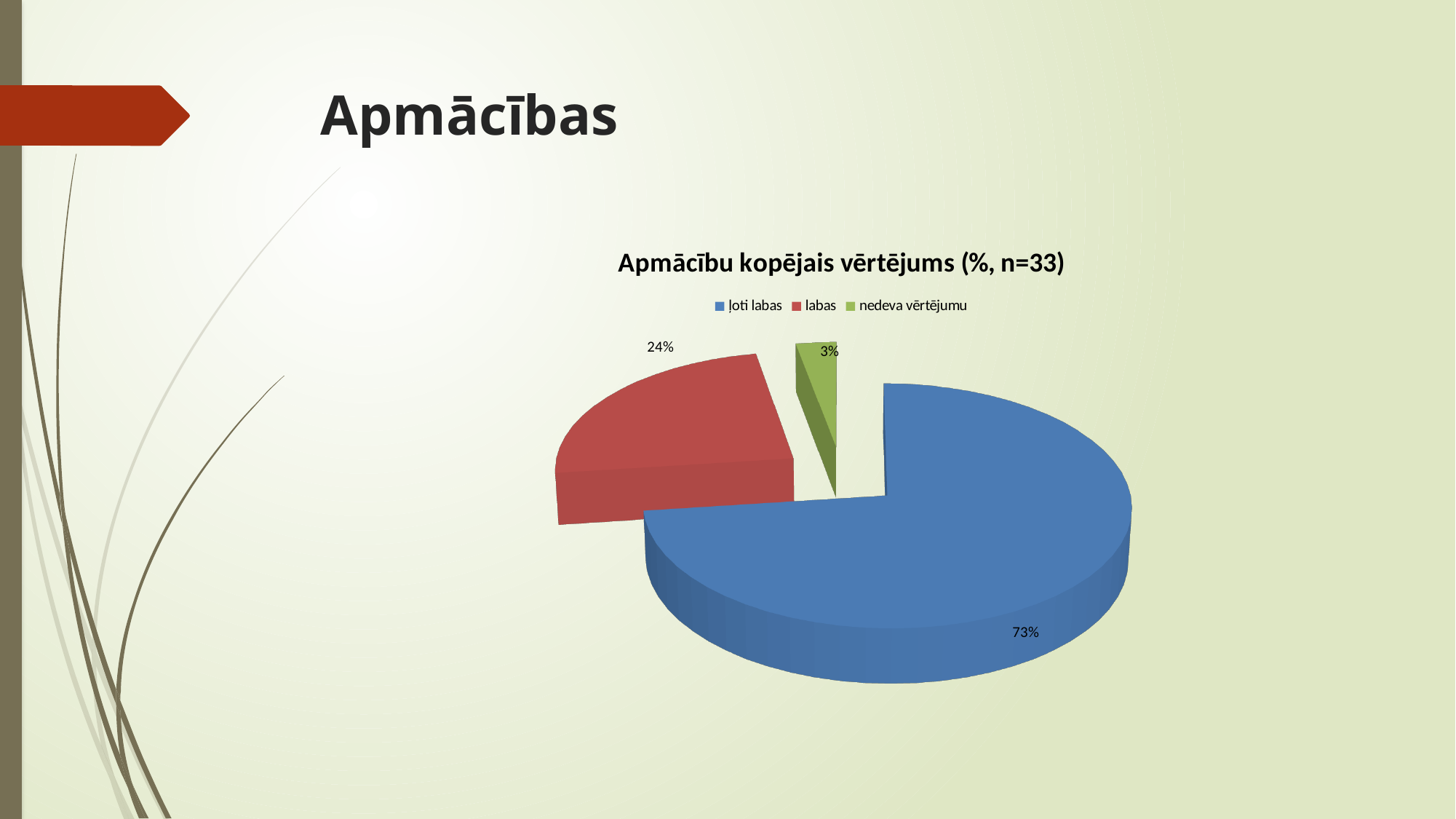
Which category has the smallest slice of the pie? nedeva vērtējumu What colour is the "labas" slice? red How many entries does the legend list? 3 Which slice is larger, "labas" or "nedeva vērtējumu"? labas What is the difference in percentage points between the "ļoti labas" and "labas" slices? 49 What is the title of the chart? Apmācību kopējais vērtējums (%, n=33) Which category has the largest slice of the pie? ļoti labas How many slices does the pie chart have? 3 What share of the pie is labelled "labas"? 24% What share of the pie is labelled "nedeva vērtējumu"? 3% What share of the pie is labelled "ļoti labas"? 73% What kind of chart is shown on the slide? pie chart